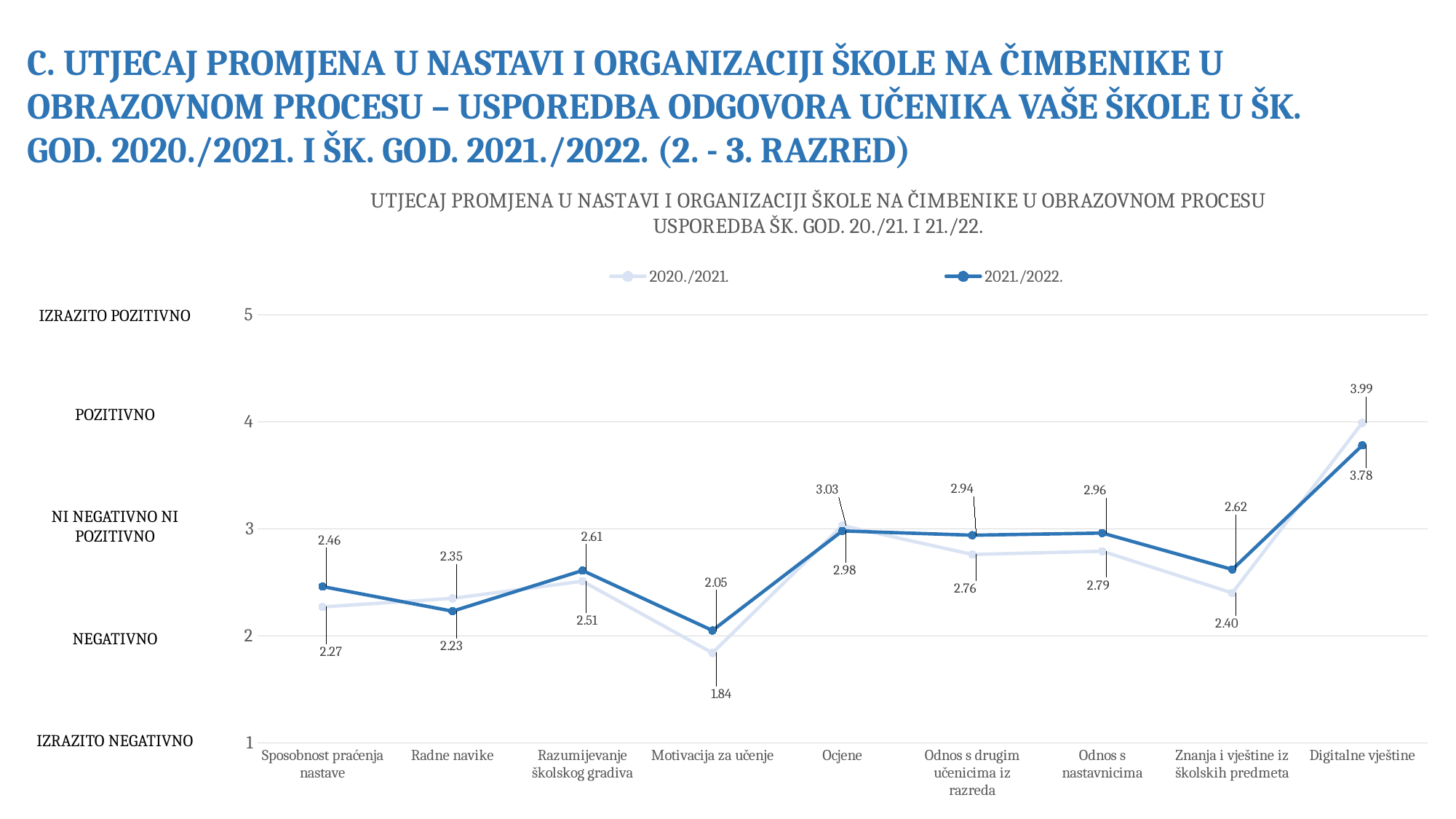
What is the 2021./2022. value for Odnos s nastavnicima? 2.96 For Ocjene, which series has the larger value, 2020./2021. or 2021./2022.? 2020./2021. Is the 2020./2021. value for Motivacija za učenje greater or less than 2? less What kind of chart is shown on the slide? line chart How many categories are shown on the x axis? 9 What label is shown next to the value 5 on the y axis? IZRAZITO POZITIVNO Which category has the lowest 2020./2021. value? Motivacija za učenje How many series does the legend list? 2 What is the 2020./2021. value for Digitalne vještine? 3.99 What is the 2021./2022. value for Motivacija za učenje? 2.05 What is the difference between the 2021./2022. and 2020./2021. values for Znanja i vještine iz školskih predmeta? 0.22 Which category has the highest 2021./2022. value? Digitalne vještine